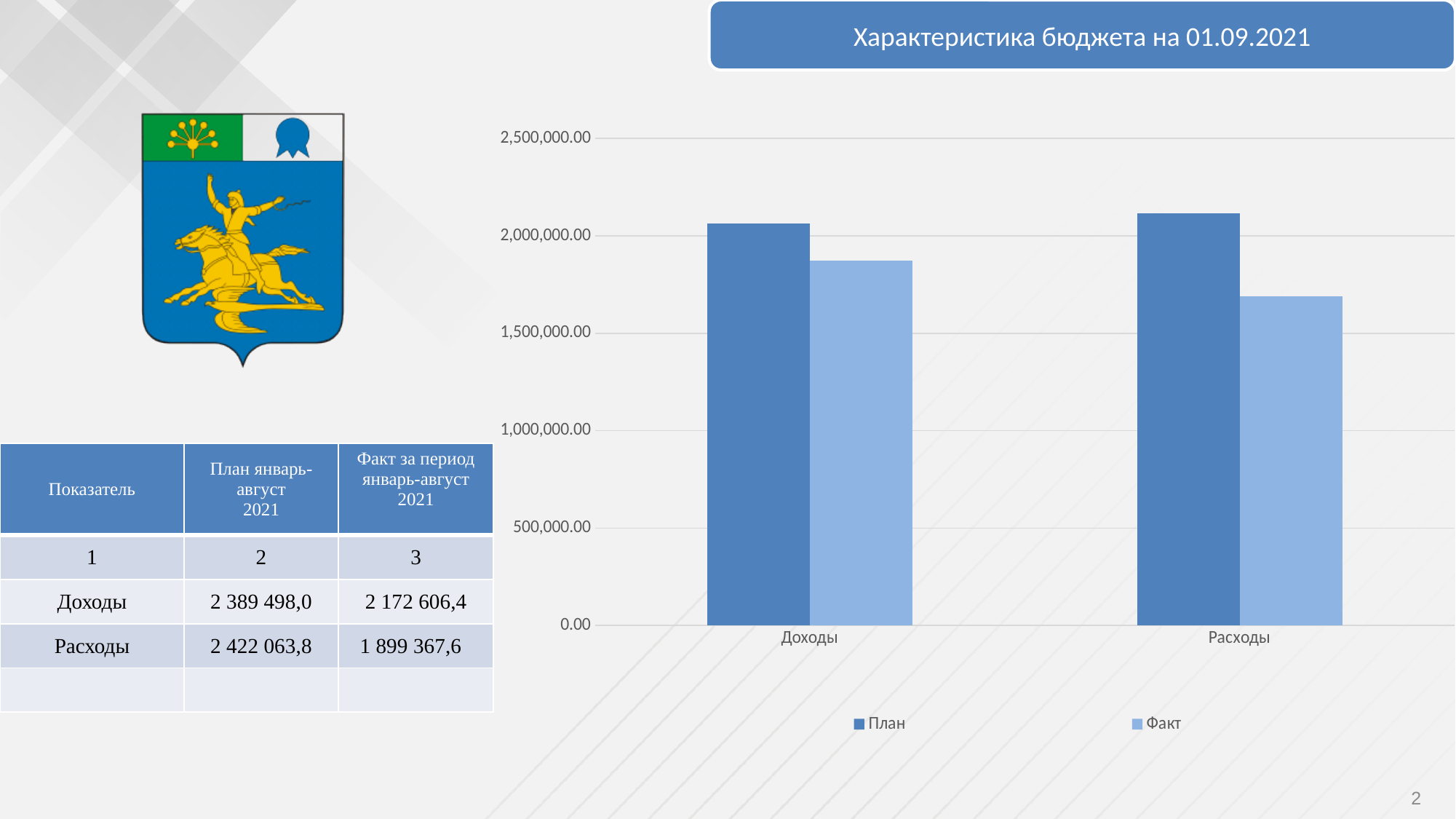
Is the Факт value for Расходы greater or less than 1,500,000.00? greater Is the Факт value for Доходы greater or less than 2,000,000.00? less For Доходы, which is larger: План or Факт? План What kind of chart is shown on the slide? bar chart What are the two series named in the chart legend? План and Факт Which bar in the chart is the lowest? Факт for Расходы Is the План value for Расходы greater or less than 2,000,000.00? greater How many categories are shown on the x axis of the chart? 2 Which category has the larger Факт value, Доходы or Расходы? Доходы How many series does the chart legend list? 2 What is the title of the slide containing the chart? Характеристика бюджета на 01.09.2021